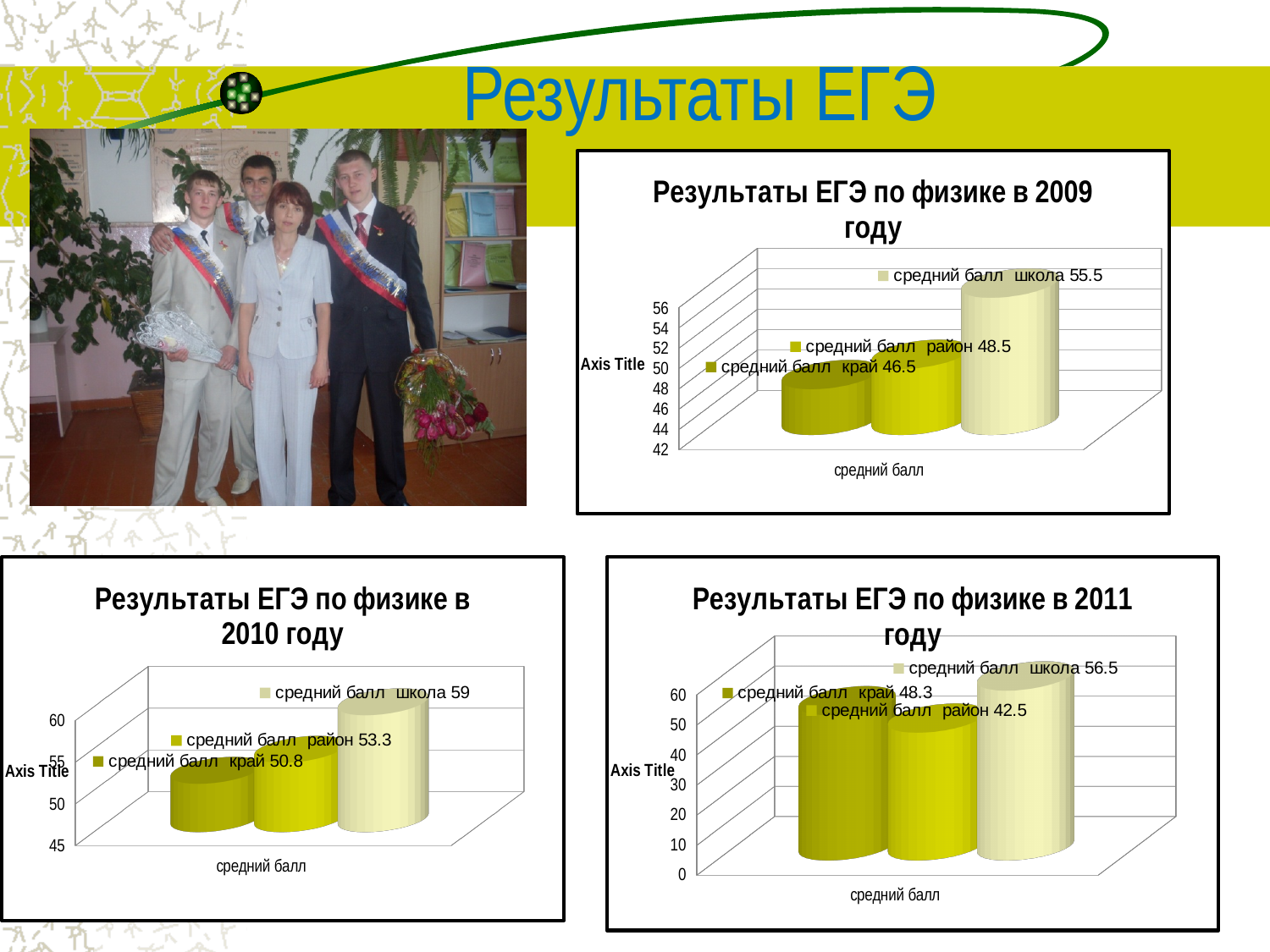
In the chart 'Результаты ЕГЭ по физике в 2011 году', which is larger, 'средний балл край' or 'средний балл район'? средний балл край In the chart 'Результаты ЕГЭ по физике в 2009 году', what is the value for 'средний балл край'? 46.5 In the chart 'Результаты ЕГЭ по физике в 2009 году', what is the difference between 'средний балл школа' and 'средний балл район'? 7 In the chart 'Результаты ЕГЭ по физике в 2009 году', what is the value for 'средний балл школа'? 55.5 In the chart 'Результаты ЕГЭ по физике в 2010 году', which series has the highest value? средний балл школа What kind of chart is 'Результаты ЕГЭ по физике в 2010 году'? bar chart In the chart 'Результаты ЕГЭ по физике в 2009 году', which series has the lowest value? средний балл край In the chart 'Результаты ЕГЭ по физике в 2010 году', what is the difference between 'средний балл район' and 'средний балл край'? 2.5 In the chart 'Результаты ЕГЭ по физике в 2011 году', what is the difference between 'средний балл школа' and 'средний балл край'? 8.2 How many series does the legend list in the chart 'Результаты ЕГЭ по физике в 2011 году'? 3 In the chart 'Результаты ЕГЭ по физике в 2010 году', what is the value for 'средний балл район'? 53.3 In the chart 'Результаты ЕГЭ по физике в 2011 году', what is the value for 'средний балл район'? 42.5